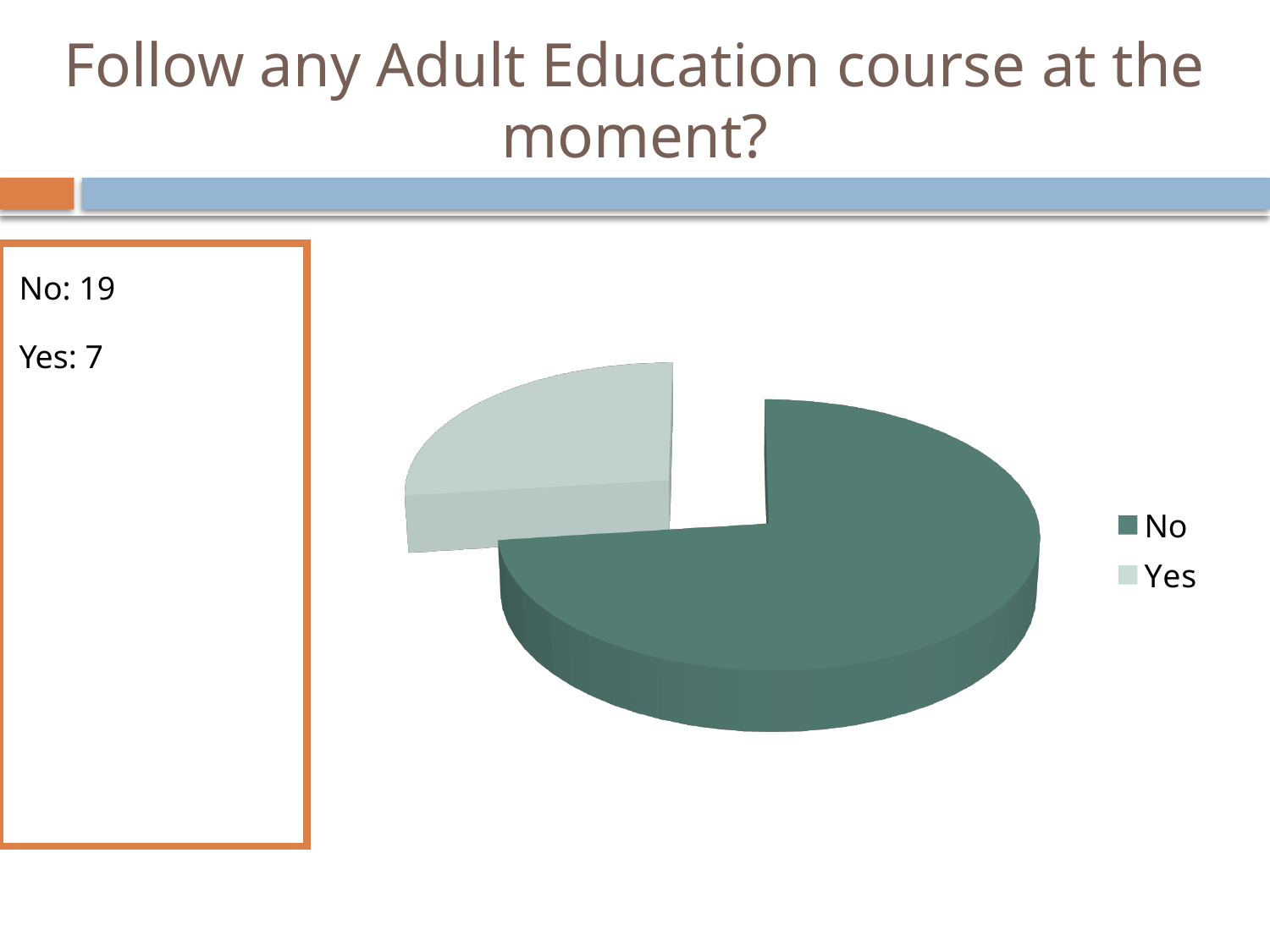
Which is larger, the value for No or the value for Yes? No Which legend entry is shown in the lighter colour? Yes What is the difference between the No and Yes values? 12 What is the title of the slide containing the pie chart? Follow any Adult Education course at the moment? What is the value for Yes? 7 Which category has the smallest slice of the pie? Yes How many entries does the legend list? 2 How many slices does the pie chart have? 2 What is the value for No? 19 What is the total of the No and Yes values? 26 Which category has the largest slice of the pie? No What type of chart is shown on the slide? pie chart